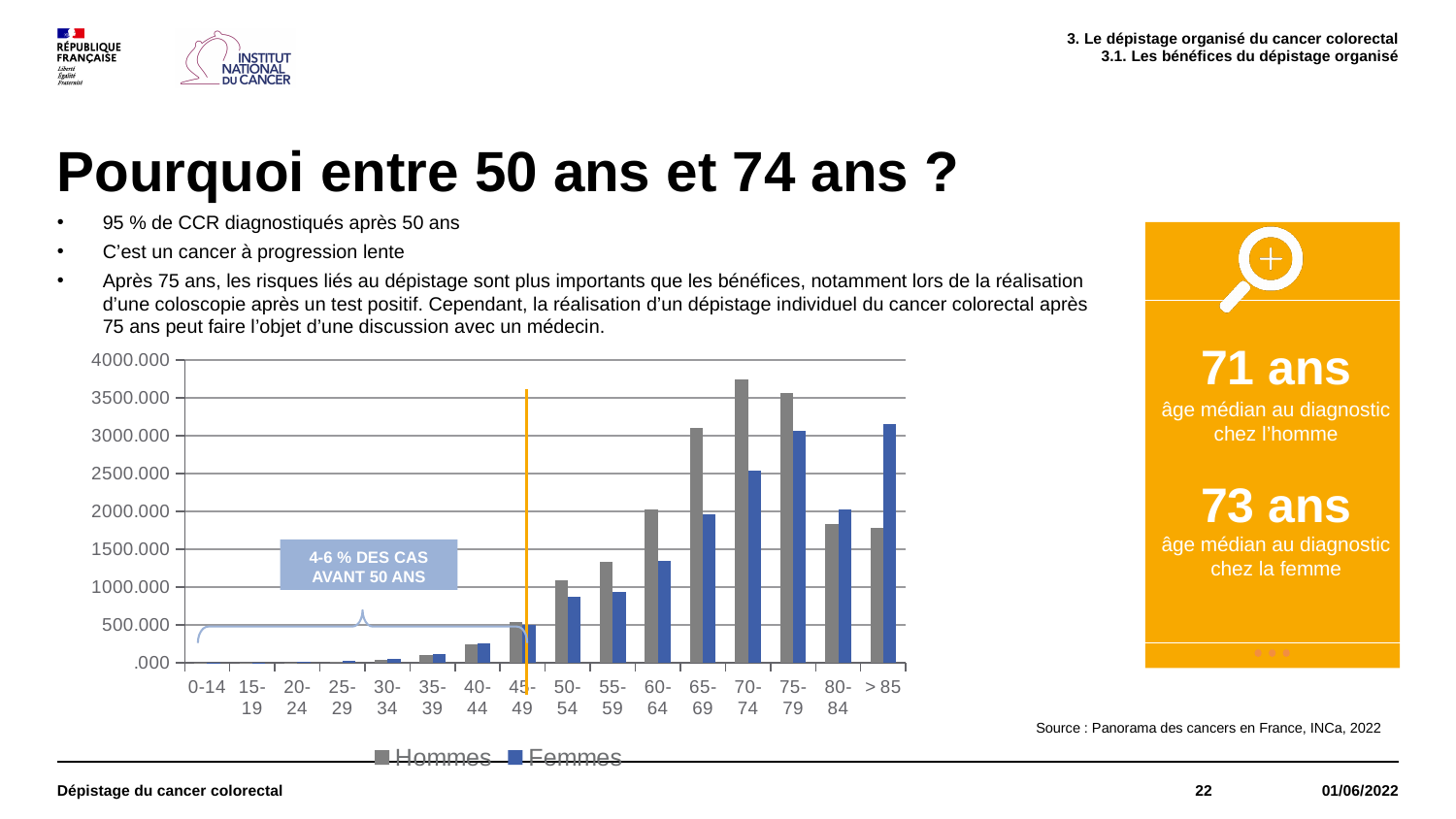
Is the value for Femmes in the 70-74 age group greater or less than 3000.000? less How many age categories are shown on the x axis of the chart? 16 In the > 85 age group, which series has the larger value, Hommes or Femmes? Femmes In the 70-74 age group, which series has the larger value, Hommes or Femmes? Hommes Which colour represents the Femmes series in the chart? blue Is the value for Femmes in the 60-64 age group greater or less than 1500.000? less Is the value for Hommes in the 70-74 age group greater or less than 3500.000? greater What kind of chart is shown on the slide? bar chart Do the values for Hommes rise or fall from the 45-49 age group to the 70-74 age group? rise Which age category has the highest value for Hommes? 70-74 How many series does the chart legend list? 2